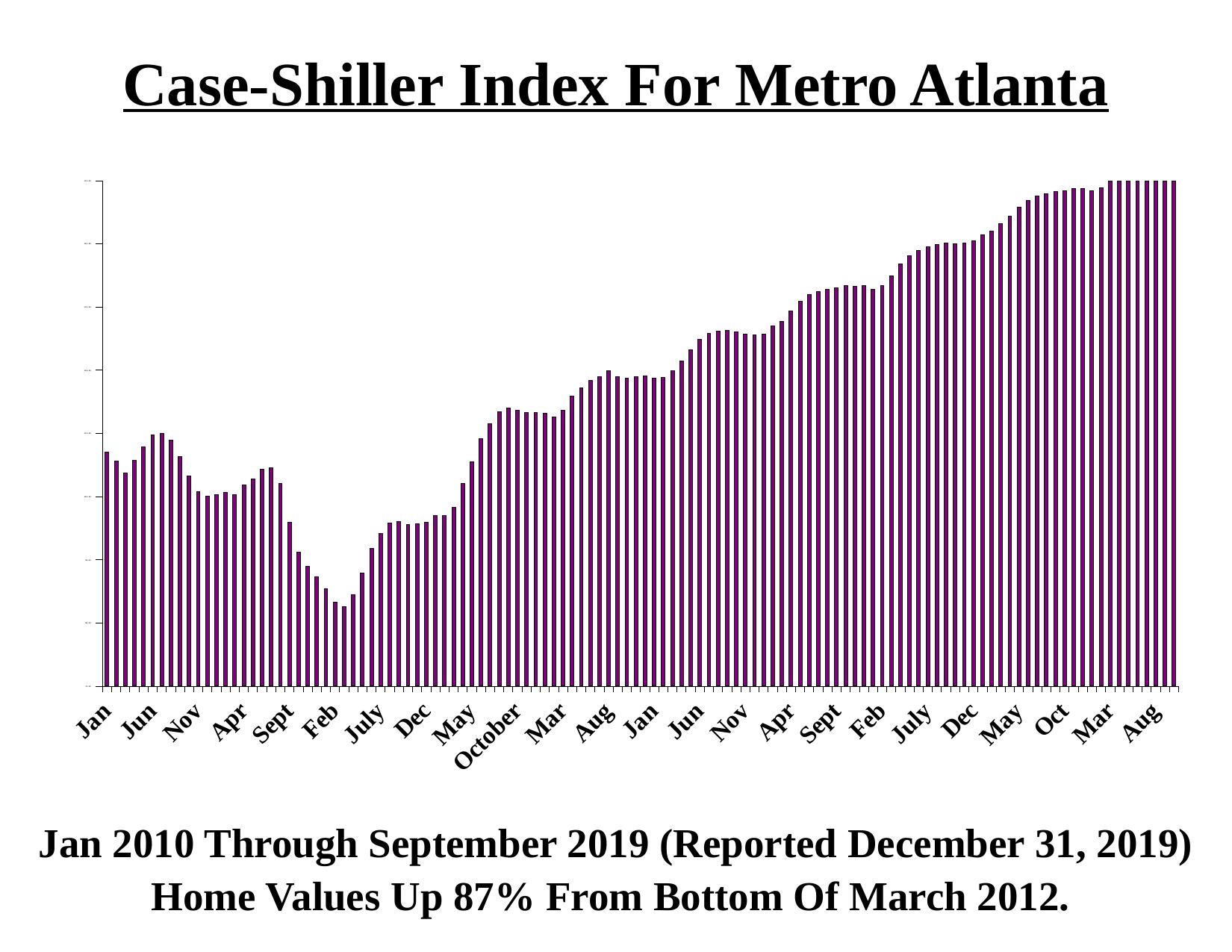
Is the last bar on the right higher or lower than the first bar on the left? higher Do the bars generally rise or fall from the Feb label to the right end of the chart? rise Which is taller: the bar at the first Nov label or the bar at the first Aug label? Aug What kind of chart is shown on the slide? bar chart Is the highest bar at the left end or the right end of the chart? right end What is the title of the chart? Case-Shiller Index For Metro Atlanta Is the lowest bar closer to the Feb label or to the Aug label? Feb According to the slide, by what percentage are home values up from the bottom of March 2012? 87%